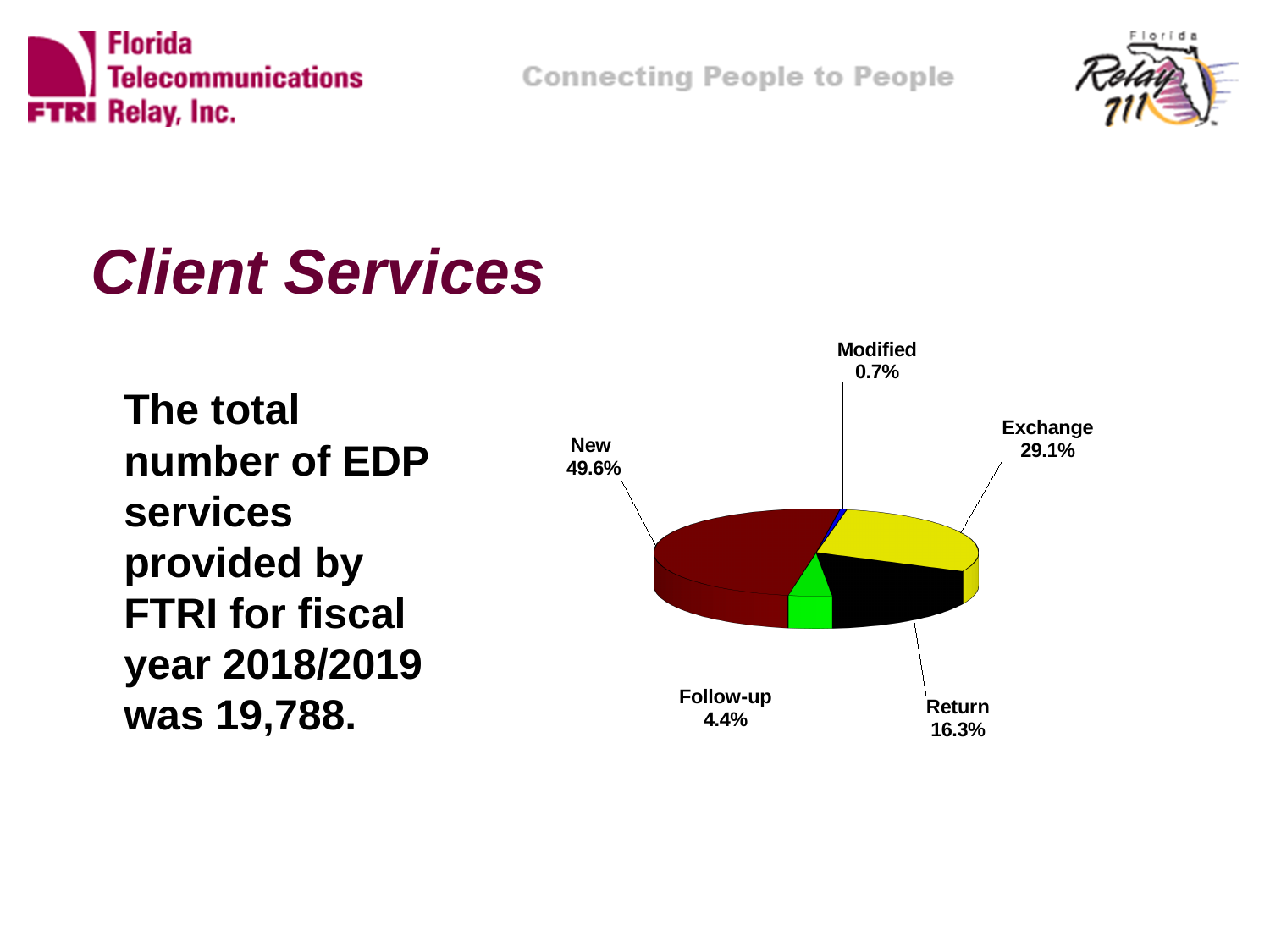
What share of EDP services is labelled as Exchange? 29.1% What share of EDP services is labelled as Modified? 0.7% What colour is the New slice of the pie? dark red What share of EDP services is labelled as Return? 16.3% How many categories are shown in the pie chart? 5 What share of EDP services is labelled as New? 49.6% Which category has the smallest share of the pie? Modified What is the difference in percentage points between the New and Exchange shares? 20.5 What share of EDP services is labelled as Follow-up? 4.4% Which is larger, the Return share or the Follow-up share? Return What kind of chart is shown on the slide? pie chart Which category has the largest share of the pie? New